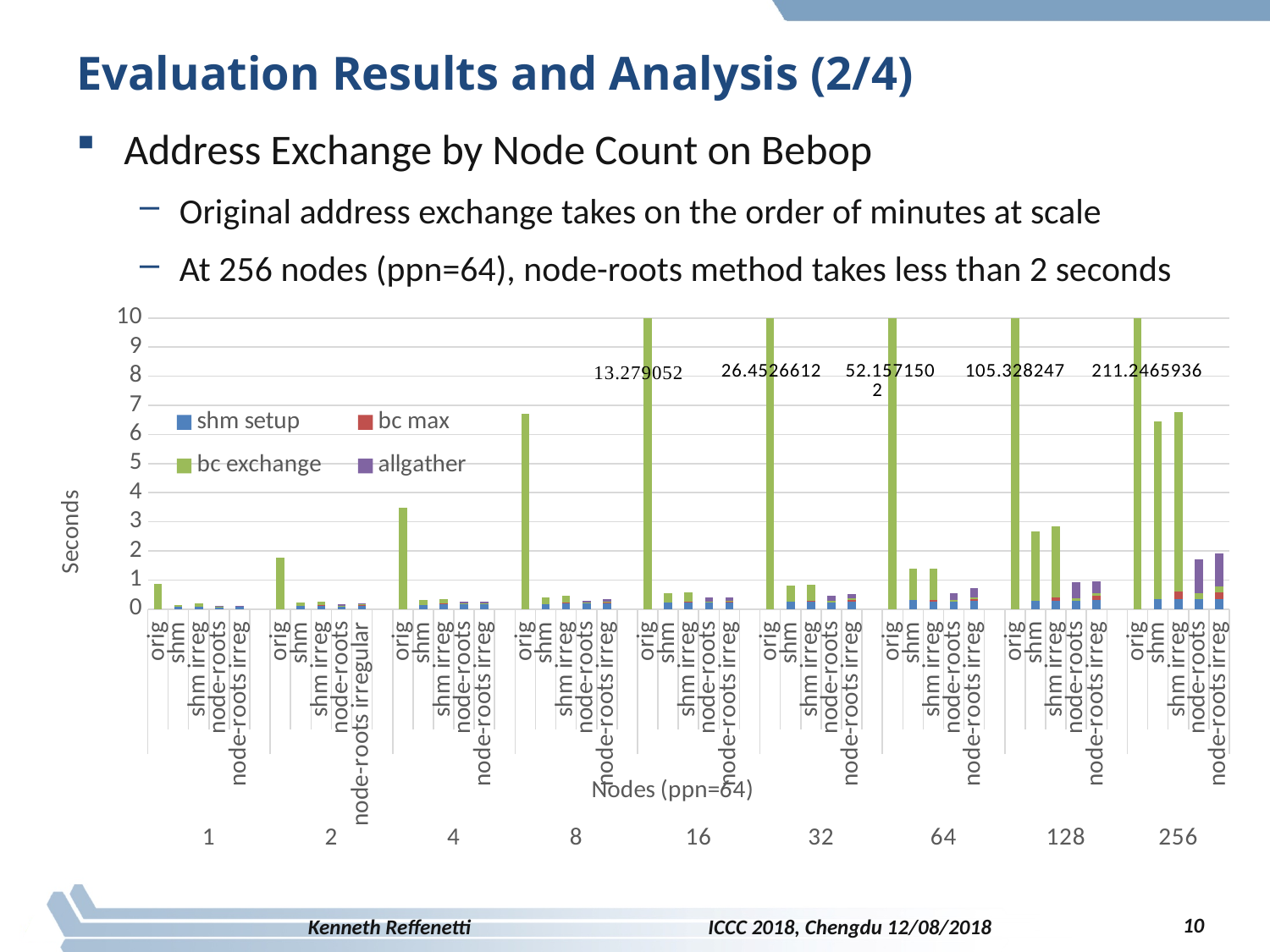
What value is labelled on the orig bar at 32 nodes? 26.4526612 How many node-count groups are shown along the x axis? 9 What is the difference between the labelled orig values at 256 nodes and 128 nodes? 105.9183466 Which is larger, the orig value at 128 nodes or the orig value at 64 nodes? 128 nodes What value is labelled on the orig bar at 128 nodes? 105.328247 How many series does the chart legend list? 4 What is the title of the x axis? Nodes (ppn=64) Is the orig bar at 1 node greater or less than 1 second? less What kind of chart is shown on the slide? bar chart What value is labelled on the orig bar at 256 nodes? 211.2465936 Is the orig bar at 4 nodes greater or less than 3 seconds? greater What value is labelled on the orig bar at 16 nodes? 13.279052